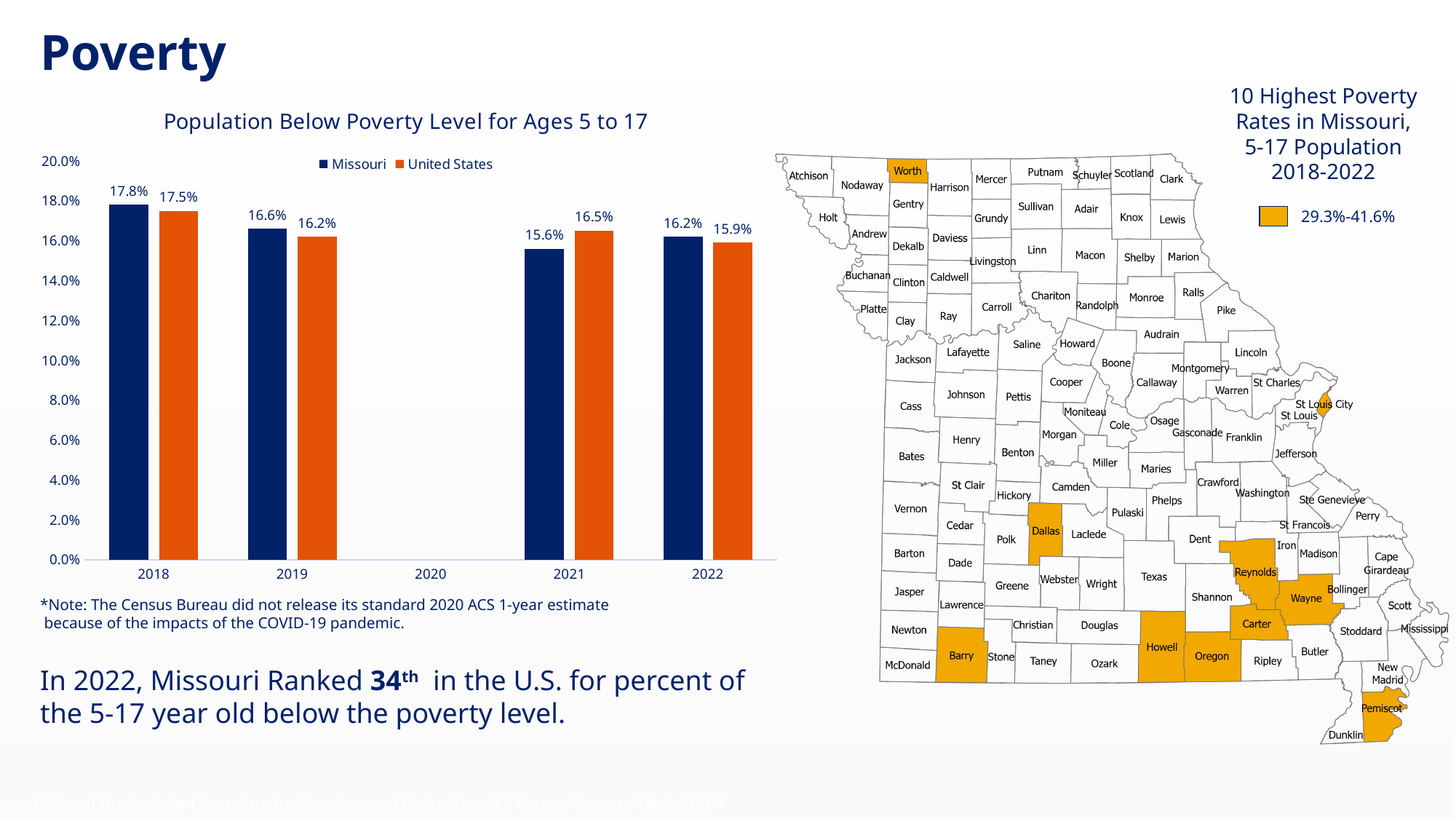
In the chart 'Population Below Poverty Level for Ages 5 to 17', which year has the highest Missouri value? 2018 What kind of chart is 'Population Below Poverty Level for Ages 5 to 17'? Bar chart In the chart 'Population Below Poverty Level for Ages 5 to 17', what is the Missouri value for 2018? 17.8% In the chart 'Population Below Poverty Level for Ages 5 to 17', what is the United States value for 2021? 16.5% In the chart 'Population Below Poverty Level for Ages 5 to 17', how many years are labeled on the x axis? 5 In the chart 'Population Below Poverty Level for Ages 5 to 17', which year has no bars plotted? 2020 In the chart 'Population Below Poverty Level for Ages 5 to 17', how many series does the legend list? 2 In the chart 'Population Below Poverty Level for Ages 5 to 17', which is larger in 2019, the Missouri value or the United States value? Missouri In the chart 'Population Below Poverty Level for Ages 5 to 17', is the Missouri value for 2021 greater or less than 16.0%? less In the chart 'Population Below Poverty Level for Ages 5 to 17', which year has the lowest United States value? 2022 In the chart 'Population Below Poverty Level for Ages 5 to 17', what is the difference between the Missouri and United States values in 2021? 0.9% In the chart 'Population Below Poverty Level for Ages 5 to 17', what is the Missouri value for 2022? 16.2%